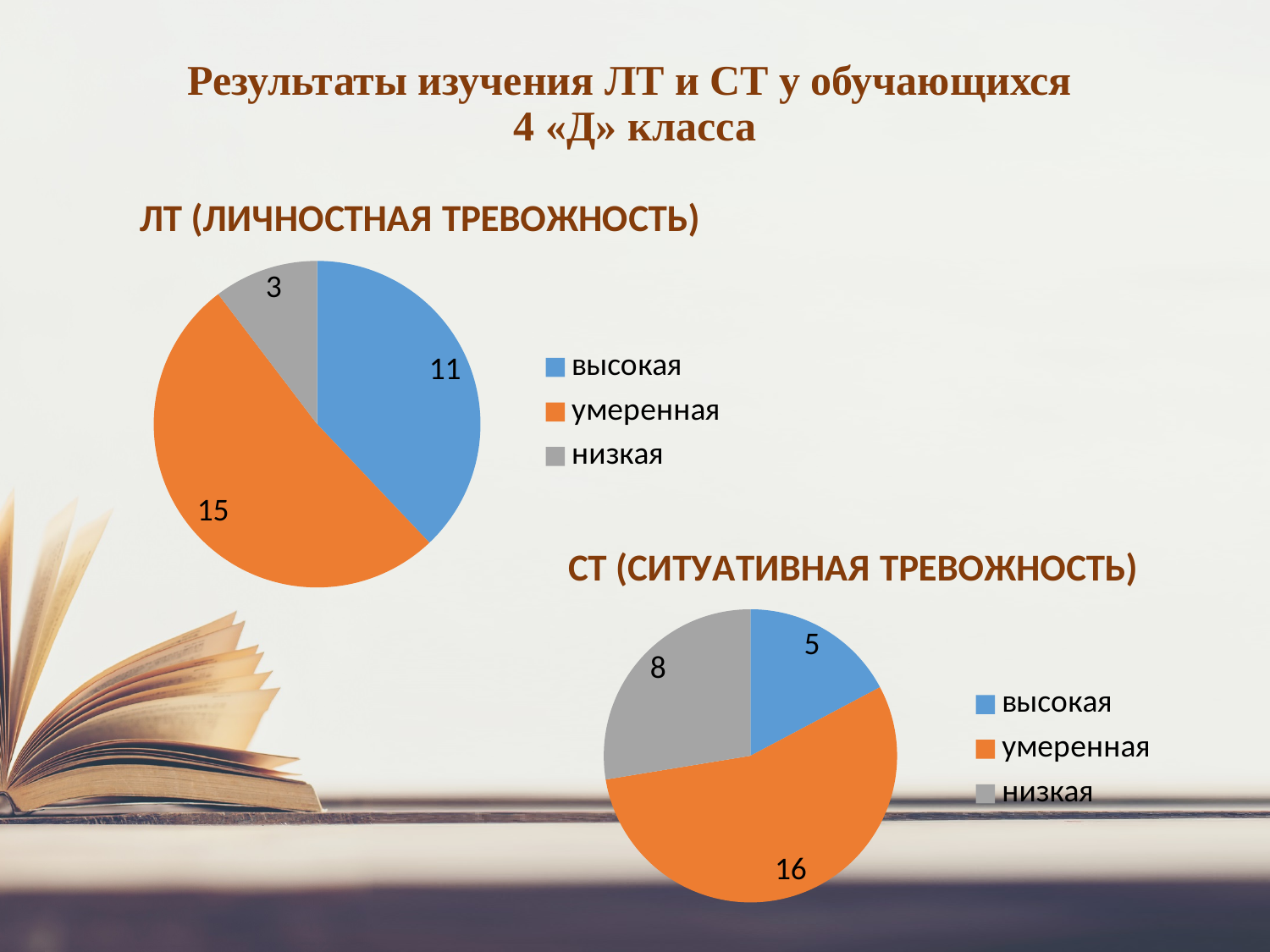
In the ЛТ (ЛИЧНОСТНАЯ ТРЕВОЖНОСТЬ) chart, what is the value for низкая? 3 Which is larger: высокая in the ЛТ chart or высокая in the СТ chart? высокая in the ЛТ chart In the СТ (СИТУАТИВНАЯ ТРЕВОЖНОСТЬ) chart, what colour is the умеренная slice? orange In the ЛТ (ЛИЧНОСТНАЯ ТРЕВОЖНОСТЬ) chart, what is the difference between умеренная and высокая? 4 How many categories does the СТ (СИТУАТИВНАЯ ТРЕВОЖНОСТЬ) chart show? 3 In the СТ (СИТУАТИВНАЯ ТРЕВОЖНОСТЬ) chart, what is the difference between умеренная and низкая? 8 In the ЛТ (ЛИЧНОСТНАЯ ТРЕВОЖНОСТЬ) chart, which category has the largest slice? умеренная In the СТ (СИТУАТИВНАЯ ТРЕВОЖНОСТЬ) chart, which category has the smallest slice? высокая In the СТ (СИТУАТИВНАЯ ТРЕВОЖНОСТЬ) chart, what is the value for высокая? 5 In the ЛТ (ЛИЧНОСТНАЯ ТРЕВОЖНОСТЬ) chart, what is the value for умеренная? 15 In the СТ (СИТУАТИВНАЯ ТРЕВОЖНОСТЬ) chart, what is the value for низкая? 8 What type of chart is the ЛТ (ЛИЧНОСТНАЯ ТРЕВОЖНОСТЬ) chart? pie chart